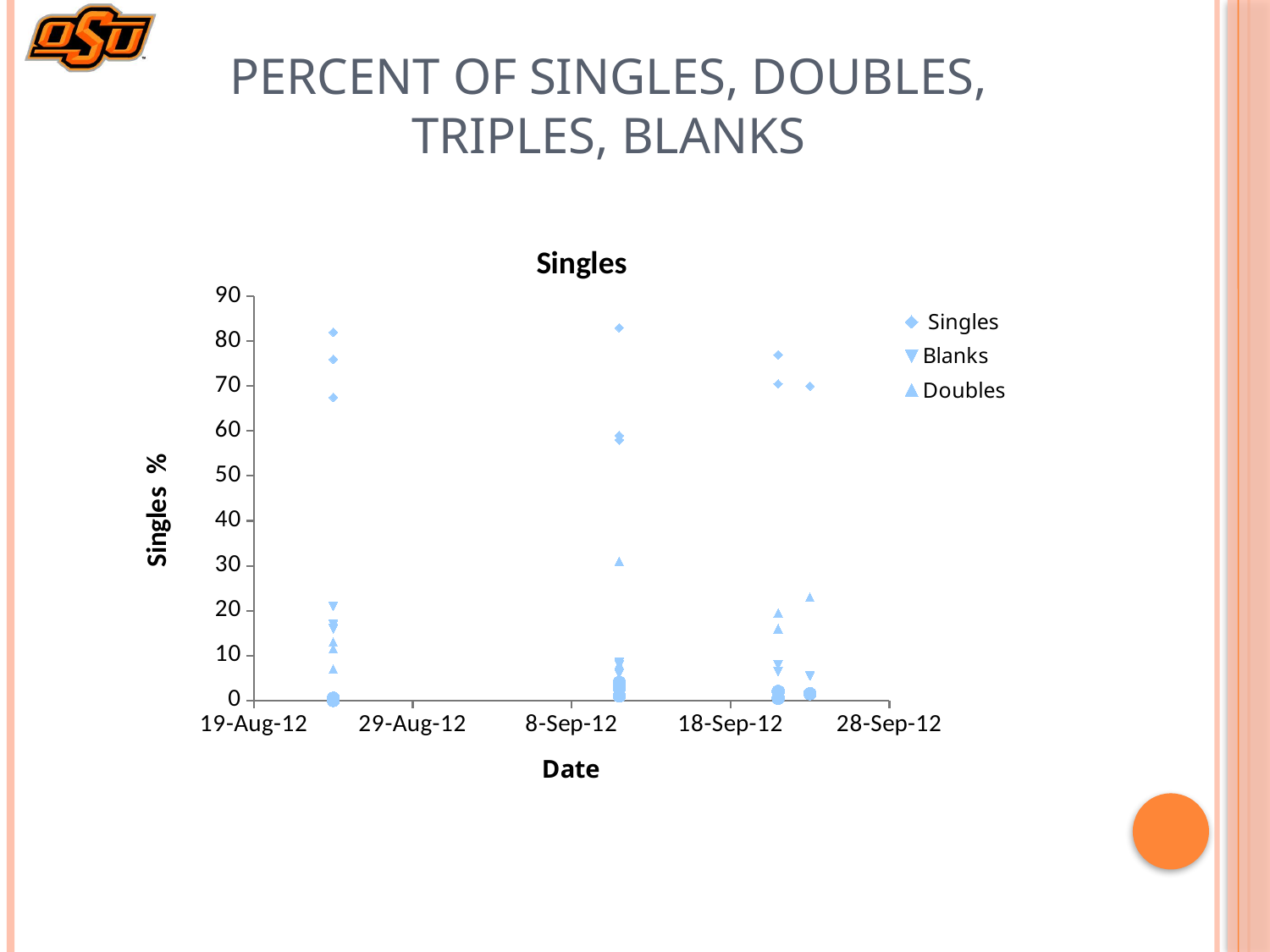
Is the highest Singles value greater or less than 80? greater Are all the Singles values greater or less than 50? greater Which series has higher values overall, Singles or Doubles? Singles How many date labels are shown on the x axis? 5 What is the title of the chart? Singles What kind of chart is shown on the slide? scatter chart What is the maximum value shown on the y axis? 90 Are all the Doubles values greater or less than 40? less How many series does the chart legend list? 3 Which series has the highest plotted values on the chart? Singles What is the label of the vertical axis? Singles %